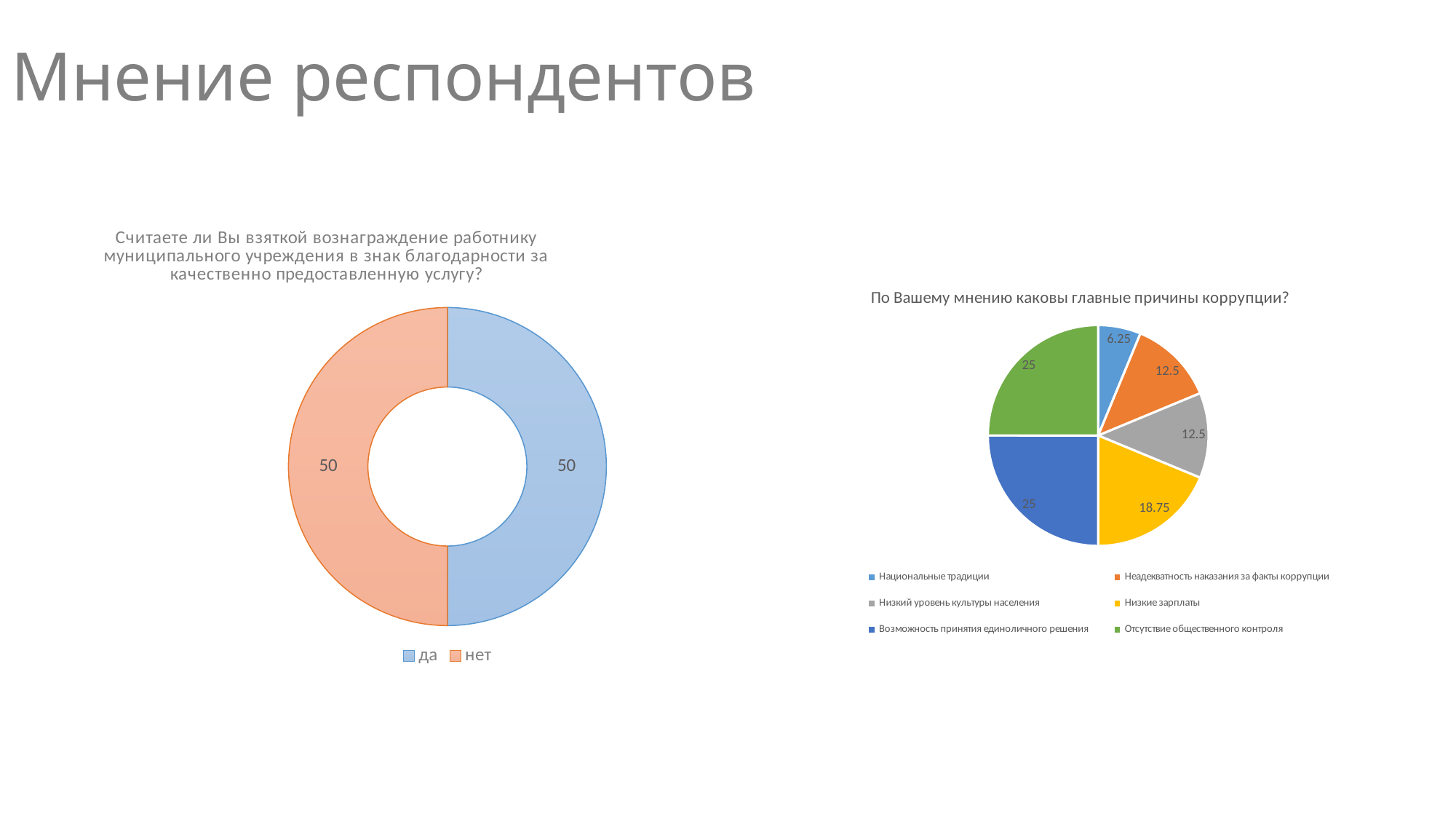
In the left chart ("Считаете ли Вы взяткой вознаграждение..."), what is the value for "нет"? 50 In the right chart ("По Вашему мнению каковы главные причины коррупции?"), what is the difference between "Низкие зарплаты" and "Неадекватность наказания за факты коррупции"? 6.25 In the left chart ("Считаете ли Вы взяткой вознаграждение..."), what is the value for "да"? 50 In the right chart ("По Вашему мнению каковы главные причины коррупции?"), what is the value for "Национальные традиции"? 6.25 In the right chart ("По Вашему мнению каковы главные причины коррупции?"), how many categories are shown? 6 In the right chart ("По Вашему мнению каковы главные причины коррупции?"), what is the value for "Низкие зарплаты"? 18.75 In the right chart ("По Вашему мнению каковы главные причины коррупции?"), what is the value for "Отсутствие общественного контроля"? 25 In the right chart ("По Вашему мнению каковы главные причины коррупции?"), which category has the smallest slice? Национальные традиции What kind of chart is the left chart ("Считаете ли Вы взяткой вознаграждение...")? Doughnut chart In the right chart ("По Вашему мнению каковы главные причины коррупции?"), which is larger: "Возможность принятия единоличного решения" or "Низкий уровень культуры населения"? Возможность принятия единоличного решения In the left chart ("Считаете ли Вы взяткой вознаграждение..."), how many categories does the legend list? 2 In the right chart ("По Вашему мнению каковы главные причины коррупции?"), what colour is the slice for "Низкие зарплаты"? Yellow